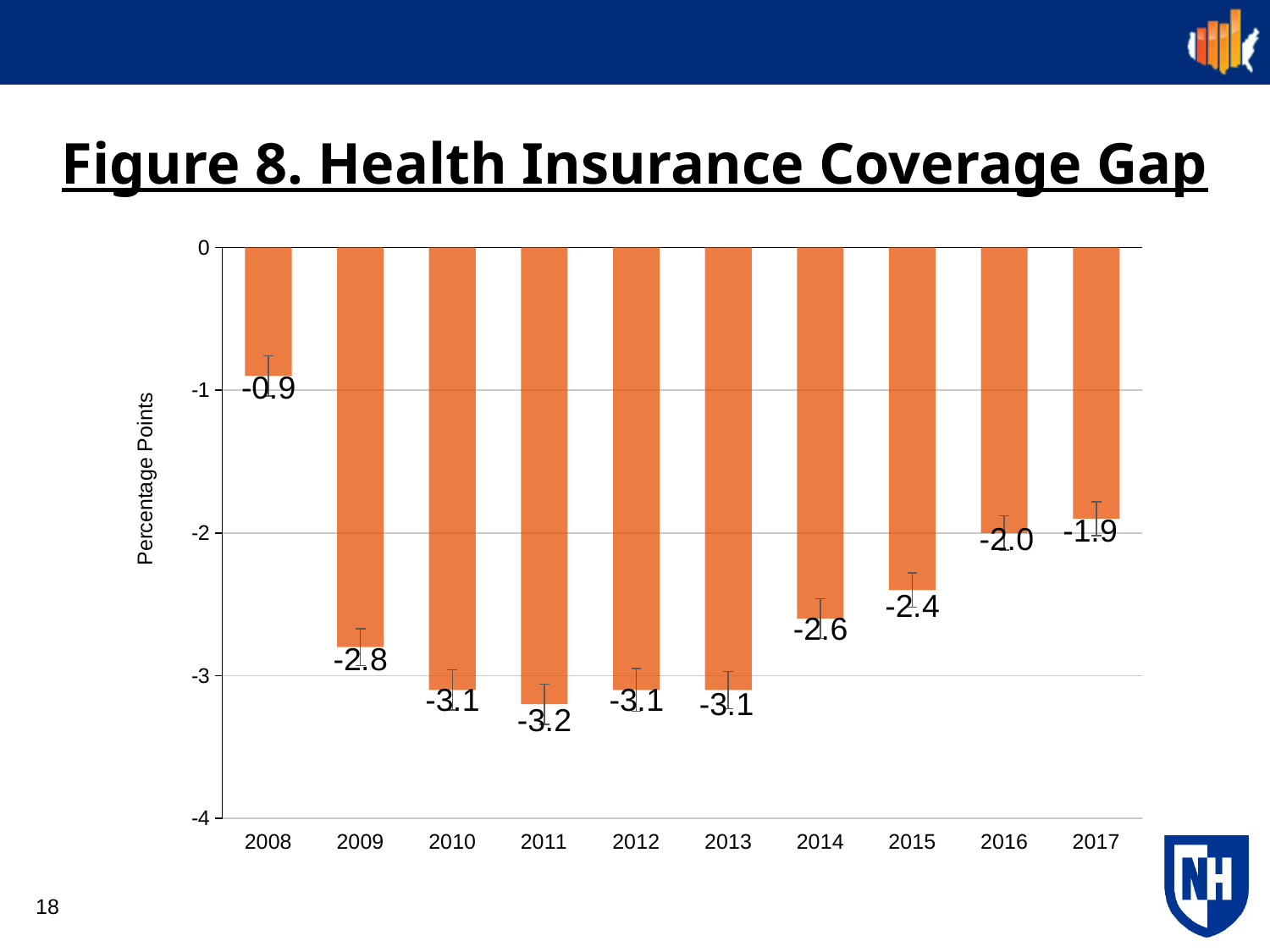
Which year has the lowest (most negative) value? 2011 What kind of chart is this? bar chart Which year has the highest (least negative) value? 2008 What is the value for 2015? -2.4 Which is larger, the value for 2014 or the value for 2016? 2016 What is the difference between the values for 2011 and 2017? 1.3 Do the values rise or fall from 2013 to 2017? rise How many years are shown on the x axis? 10 What is the value for 2011? -3.2 What is the value for 2008? -0.9 What is the label on the y axis? Percentage Points What is the value for 2017? -1.9